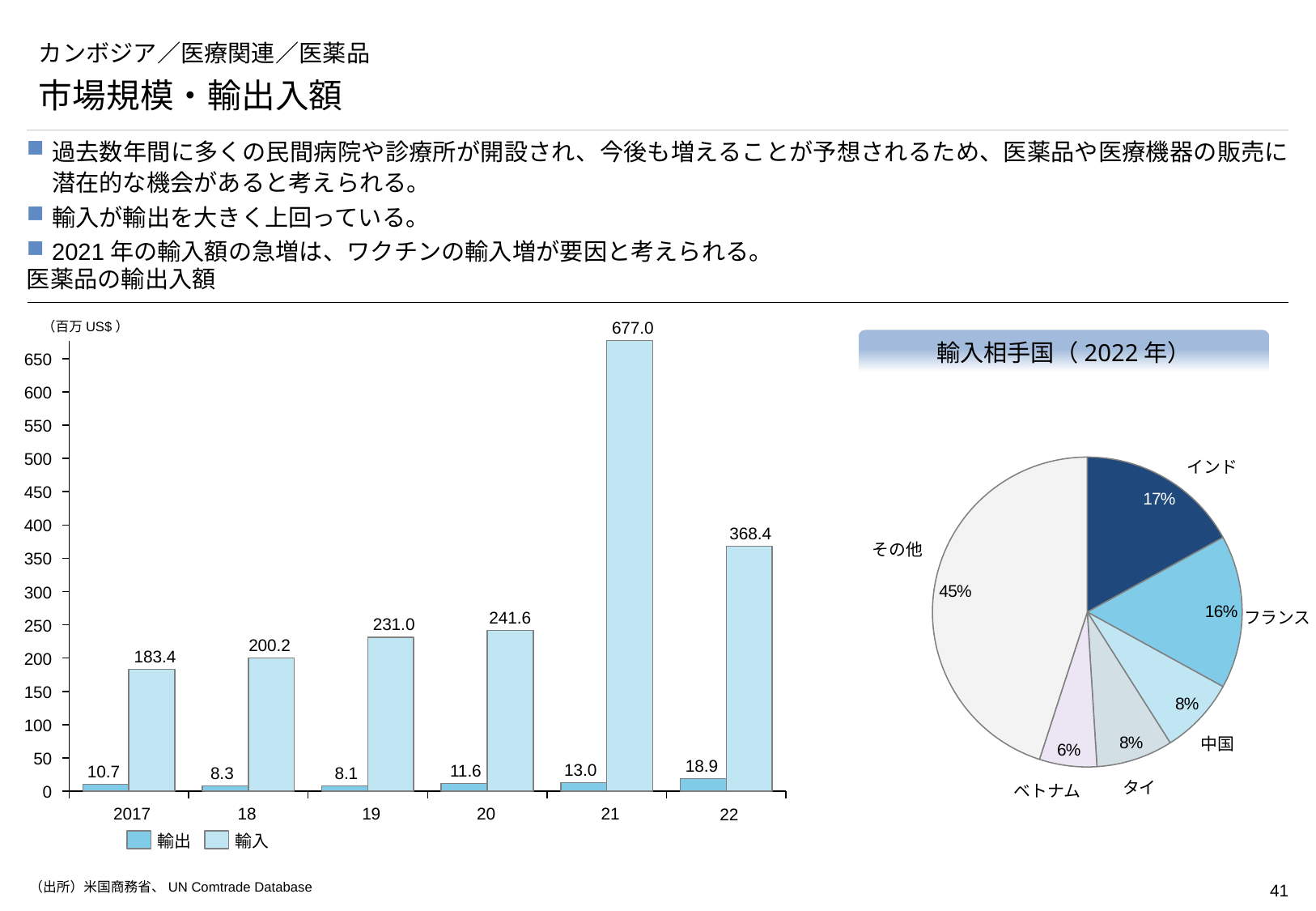
In the bar chart 医薬品の輸出入額, what is the difference between the 輸入 values for 2021 and 2022? 308.6 In the pie chart 輸入相手国（2022年）, which slice is the largest? その他 In the bar chart 医薬品の輸出入額, what is the 輸出 value for 2017? 10.7 In the bar chart 医薬品の輸出入額, which year has the lowest 輸出 value? 19 In the bar chart 医薬品の輸出入額, how many years are shown on the x axis? 6 In the bar chart 医薬品の輸出入額, does the 輸入 value rise or fall from 2017 to 2020? rise In the bar chart 医薬品の輸出入額, what is the 輸入 value for 2021? 677.0 In the bar chart 医薬品の輸出入額, which year has the highest 輸入 value? 21 What kind of chart is 輸入相手国（2022年）? pie chart In the bar chart 医薬品の輸出入額, which is larger: the 輸入 value for 2019 or for 2020? 2020 In the pie chart 輸入相手国（2022年）, what share does インド have? 17% In the bar chart 医薬品の輸出入額, how many series does the legend list? 2